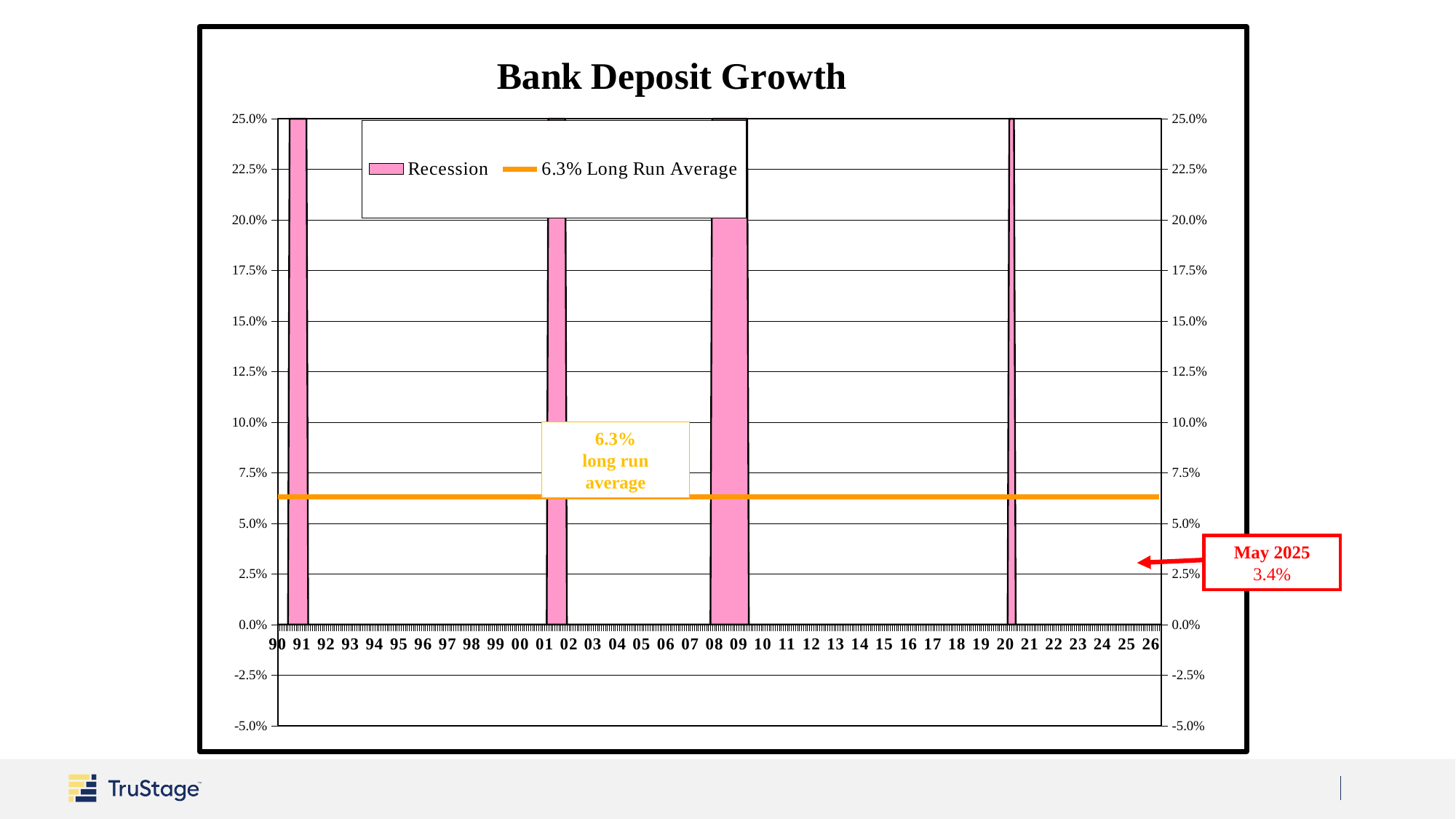
What is the highest value shown on the chart's vertical axis? 25.0% Is the May 2025 bank deposit growth value higher or lower than the 6.3% long run average? lower What is the title of the chart? Bank Deposit Growth What is the bank deposit growth value annotated for May 2025? 3.4% How many entries does the chart's legend list? 2 How many shaded recession periods are shown on the chart? 4 By how many percentage points is the May 2025 value (3.4%) below the 6.3% long run average? 2.9 percentage points What value is given for the long run average of bank deposit growth? 6.3% Is the May 2025 bank deposit growth value greater or less than 5.0%? less What is the last year label on the chart's horizontal axis? 26 What is the first year label on the chart's horizontal axis? 90 What is the lowest value shown on the chart's vertical axis? -5.0%